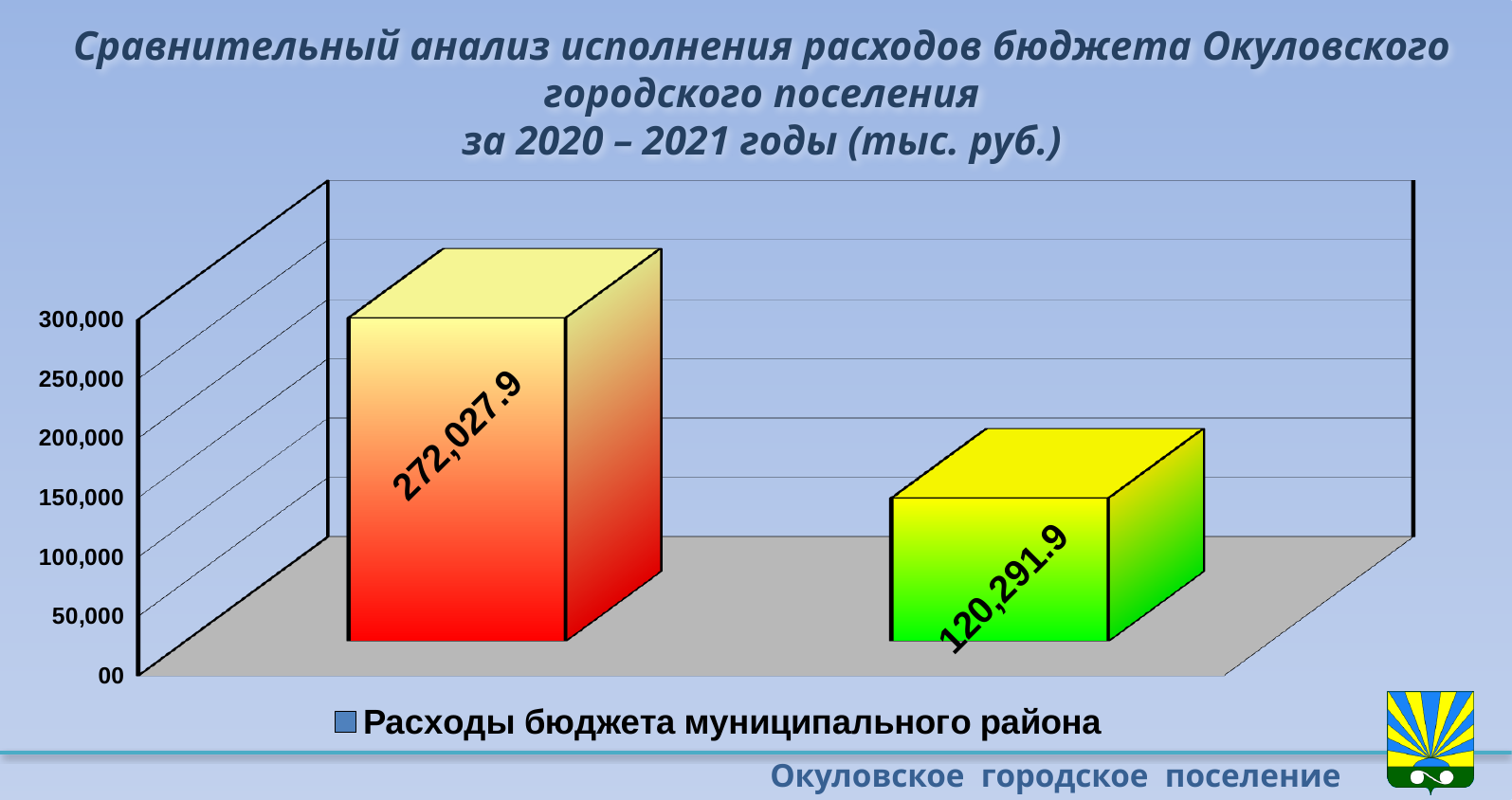
Is the value of the right bar greater or less than 150,000? less What value is shown on the left (red-yellow) bar? 272,027.9 What value is shown on the right (green-yellow) bar? 120,291.9 Is the value of the left bar larger or smaller than the value of the right bar? larger What is the legend entry shown below the chart? Расходы бюджета муниципального района What kind of chart is shown on the slide? bar chart What is the difference between the left bar's value and the right bar's value? 151,736.0 Which bar has the lower value, the left one or the right one? the right one Is the value of the left bar greater or less than 250,000? greater Which bar has the higher value, the left one or the right one? the left one How many series does the legend list? 1 How many bars are plotted on the chart? 2